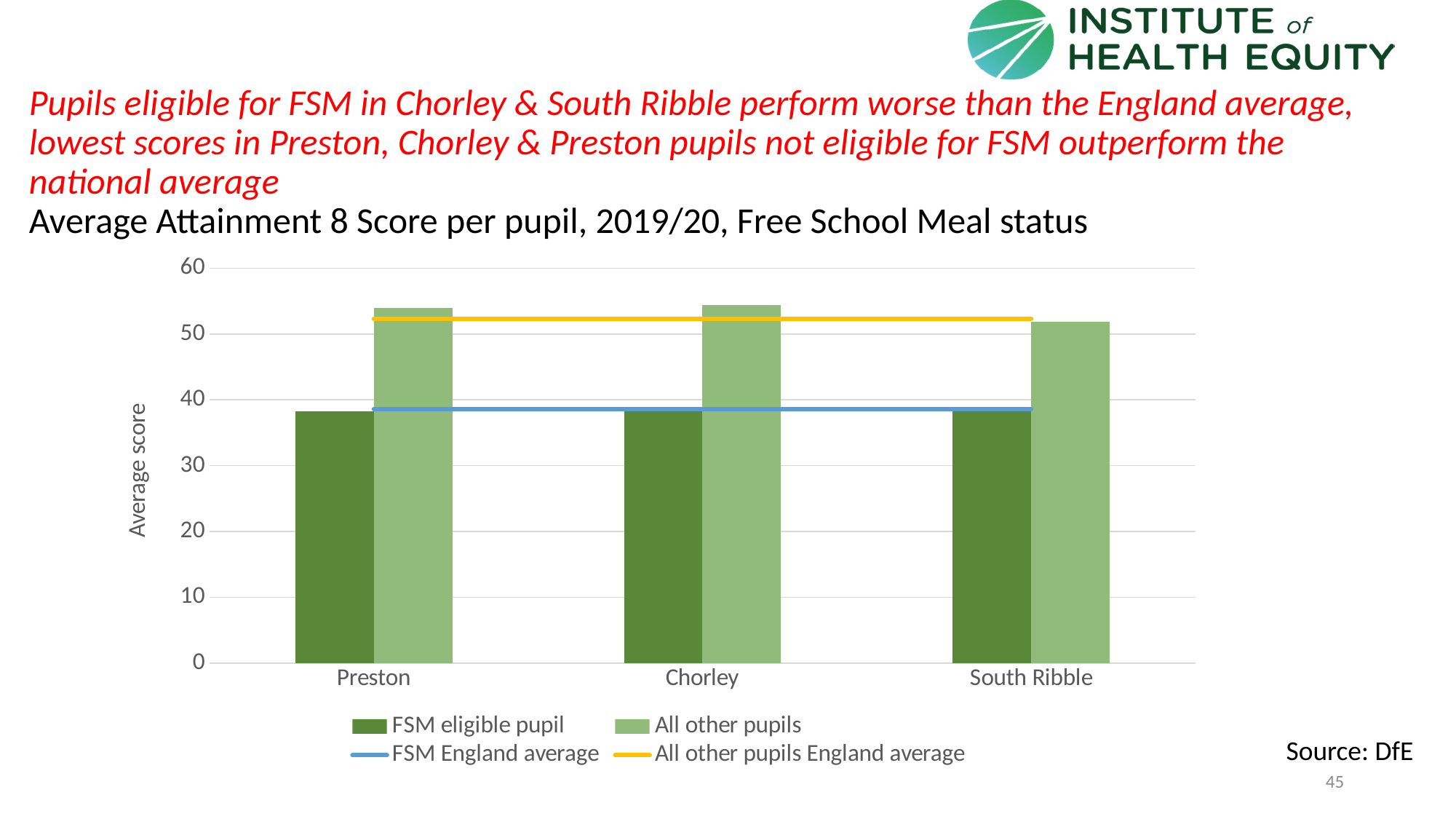
Which area has the lowest score for All other pupils? South Ribble Which line is higher on the chart: the FSM England average or the All other pupils England average? All other pupils England average Is the value for FSM eligible pupils in Preston greater or less than 40? less How many areas (categories) are shown on the x axis of the chart? 3 Is the value for All other pupils in Chorley greater or less than 50? greater Is the value for All other pupils in South Ribble greater or less than 50? greater How many series does the chart legend list? 4 In Chorley, which is larger: the score for FSM eligible pupils or for All other pupils? All other pupils What is the label on the y axis of the chart? Average score What kind of chart is shown on the slide? Combination bar and line chart What is the title of the chart? Average Attainment 8 Score per pupil, 2019/20, Free School Meal status